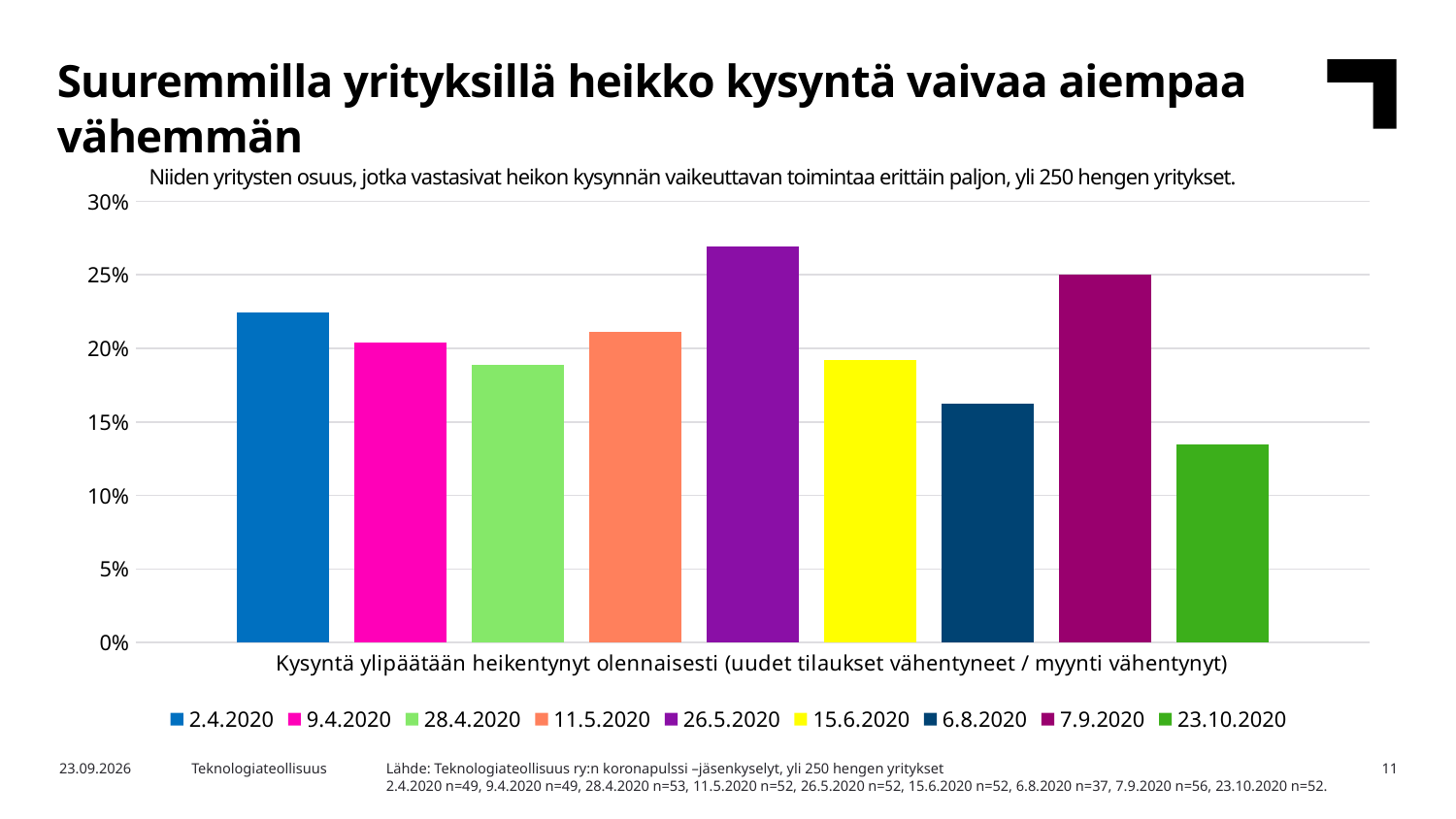
Is the value for 2.4.2020 greater or less than 20%? greater Which survey date has the lowest bar? 23.10.2020 Which is larger, the value for 2.4.2020 or the value for 9.4.2020? 2.4.2020 Which is larger, the value for 7.9.2020 or the value for 6.8.2020? 7.9.2020 Is the value for 28.4.2020 greater or less than 20%? less Is the value for 23.10.2020 greater or less than 15%? less How many series does the legend list? 9 What is the category label shown on the x axis of the chart? Kysyntä ylipäätään heikentynyt olennaisesti (uudet tilaukset vähentyneet / myynti vähentynyt) What kind of chart is shown on the slide? bar chart Which survey date has the highest bar? 26.5.2020